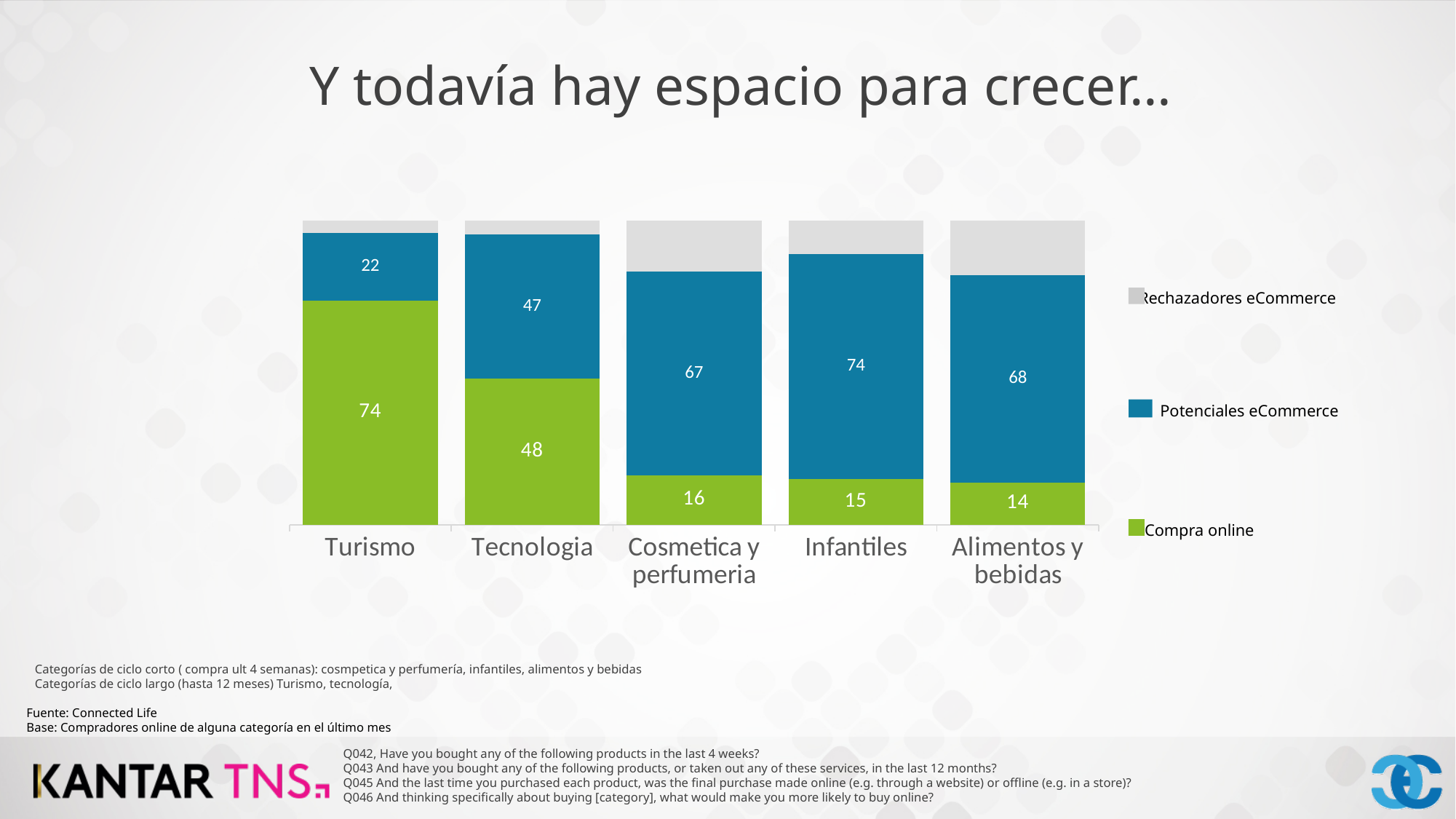
Which category has the lowest Compra online value? Alimentos y bebidas Which is larger for Cosmetica y perfumeria: the Compra online value or the Potenciales eCommerce value? Potenciales eCommerce What is the Compra online value for Turismo? 74 Which category has the highest Compra online value? Turismo What kind of chart is shown on the slide? Stacked bar chart What is the difference between the Compra online values for Turismo and Tecnologia? 26 What is the Potenciales eCommerce value for Infantiles? 74 Which category has the lowest Potenciales eCommerce value? Turismo How many categories are shown on the x axis? 5 What is the Compra online value for Alimentos y bebidas? 14 How many series does the legend list? 3 What is the Potenciales eCommerce value for Tecnologia? 47